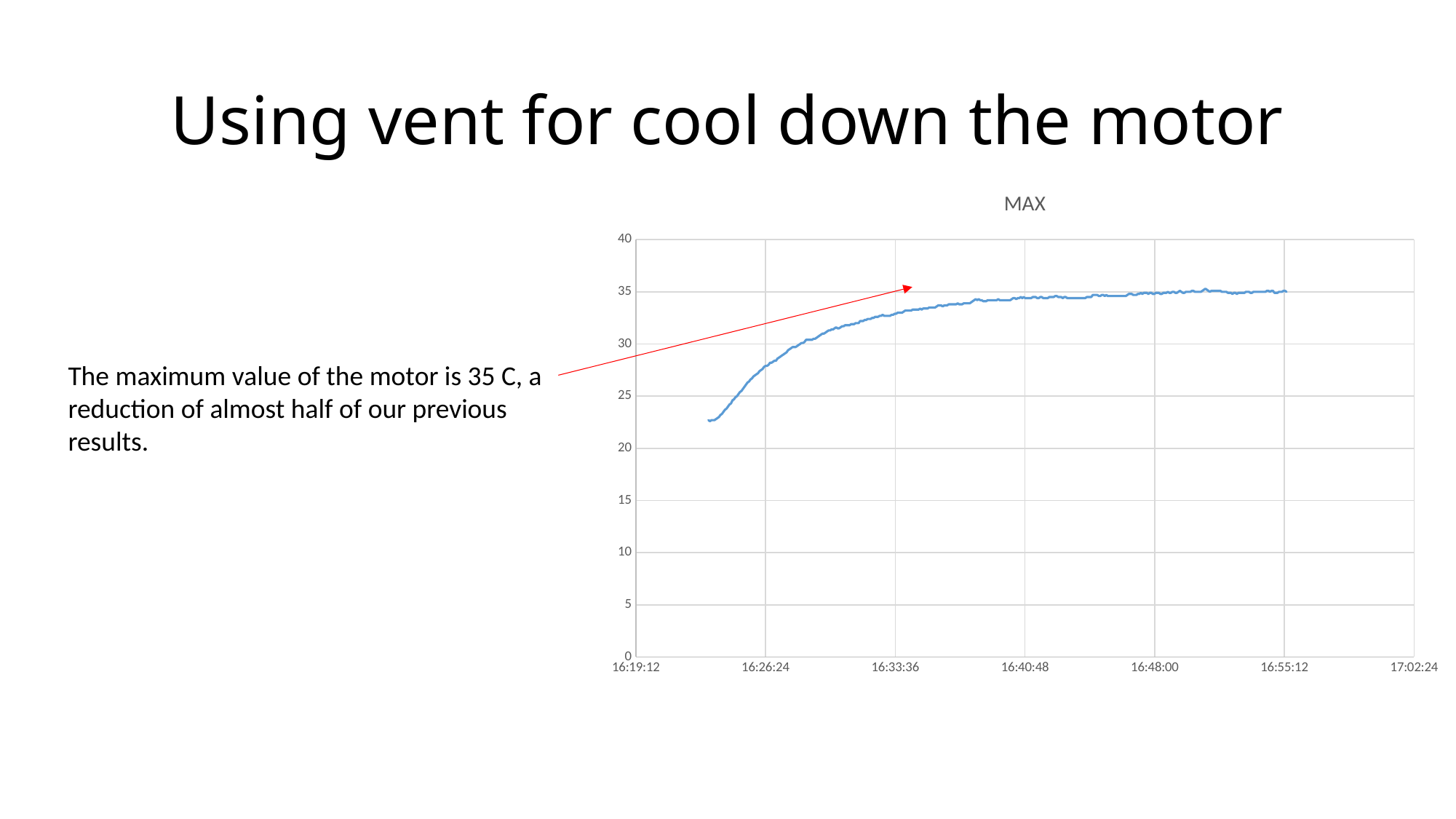
What is the highest value shown on the y axis of the MAX chart? 40 In the MAX chart, which is larger: the value at 16:26:24 or the value at 16:55:12? 16:55:12 In the MAX chart, is the value at 16:33:36 greater or less than 30? greater In the MAX chart, is the value at 16:40:48 greater or less than 30? greater What is the title of the chart? MAX In the MAX chart, is the value at the start of the line greater or less than 25? less How many time labels are shown on the x axis of the MAX chart? 7 Do the values in the MAX chart rise or fall over time along the x axis? rise What kind of chart is shown on the slide? line chart